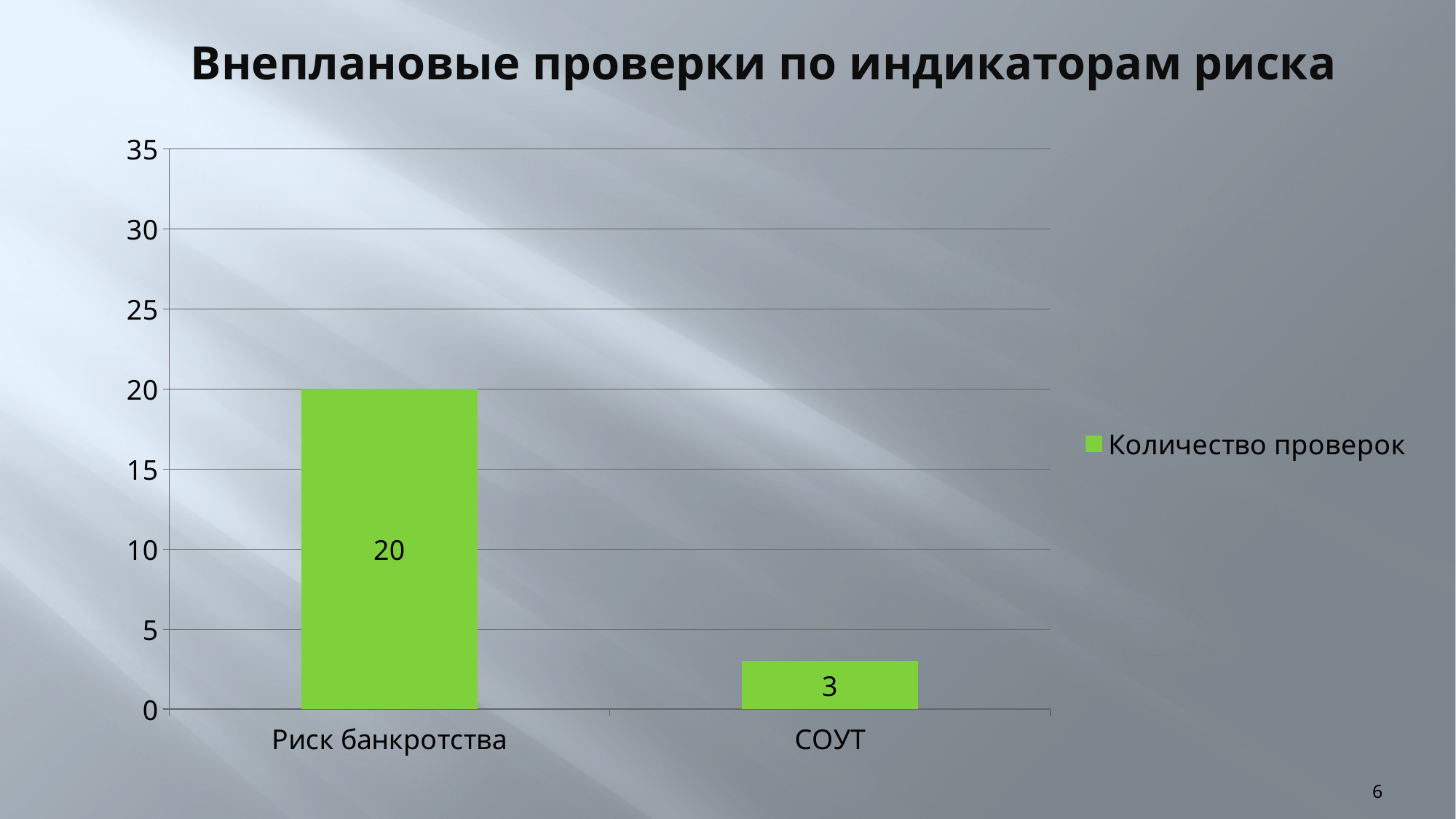
What is the name of the series in the legend? Количество проверок What kind of chart is shown on the slide? bar chart Which category has the lowest value? СОУТ Which category has the highest value? Риск банкротства What is the difference between the values for Риск банкротства and СОУТ? 17 What is the value for Риск банкротства? 20 Is the value for Риск банкротства greater or less than 15? greater Is the value for СОУТ greater or less than 5? less Which is larger, the value for Риск банкротства or the value for СОУТ? Риск банкротства How many categories are shown on the x axis? 2 How many series does the legend list? 1 What is the value for СОУТ? 3